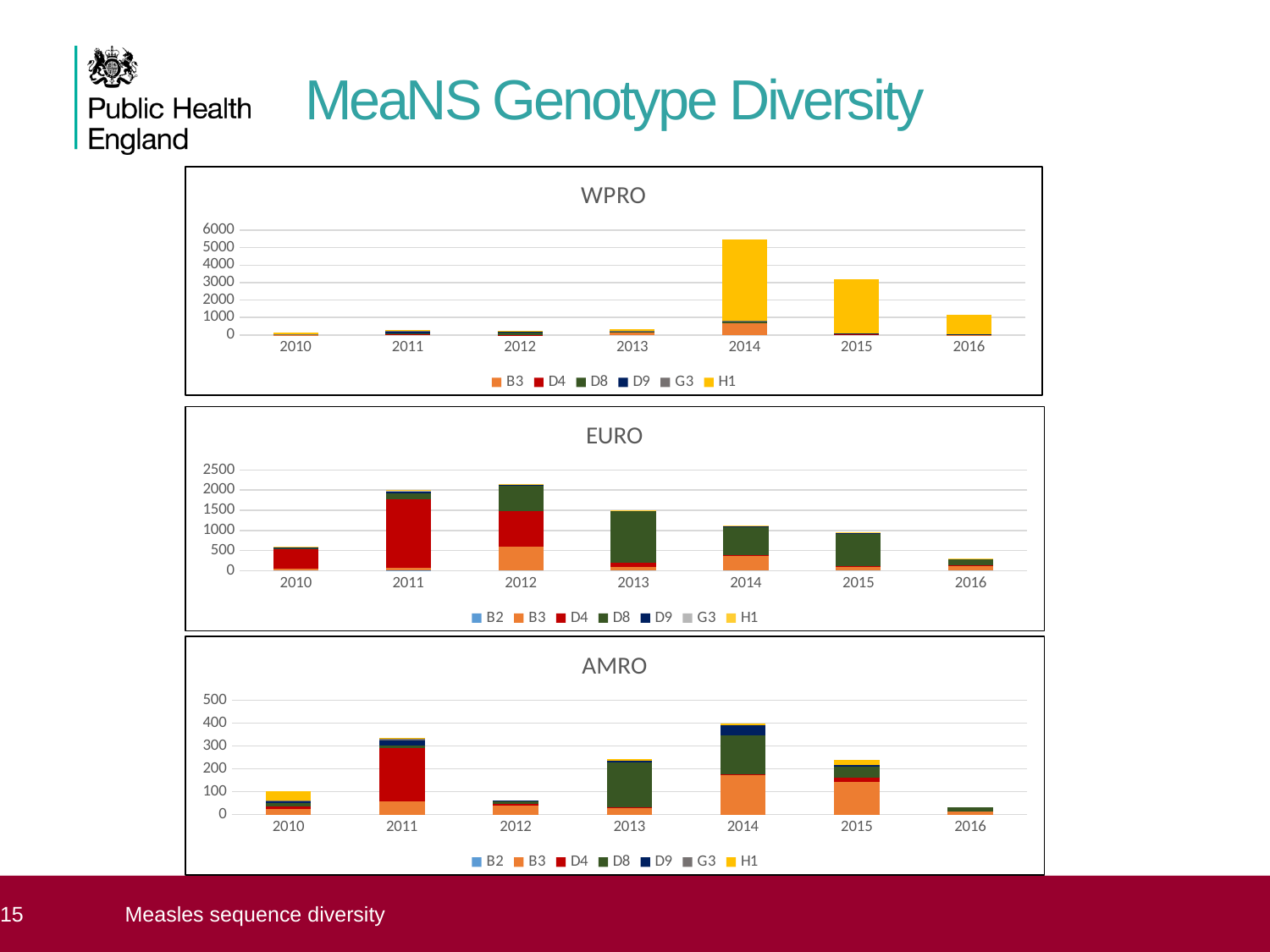
In the WPRO chart, do the totals rise or fall from 2014 to 2016? fall What kind of chart is the WPRO chart? Stacked bar chart How many series does the legend of the EURO chart list? 7 In the AMRO chart, which year has the highest total? 2014 In the EURO chart, which year has the lowest total? 2016 In the WPRO chart, which year has the highest total? 2014 In the EURO chart, is the total for 2013 greater or less than 1000? greater In the WPRO chart, is the total for 2014 greater or less than 5000? greater How many series does the legend of the WPRO chart list? 6 How many years are shown on the x axis of the WPRO chart? 7 In the WPRO chart, is the total for 2016 greater or less than 2000? less